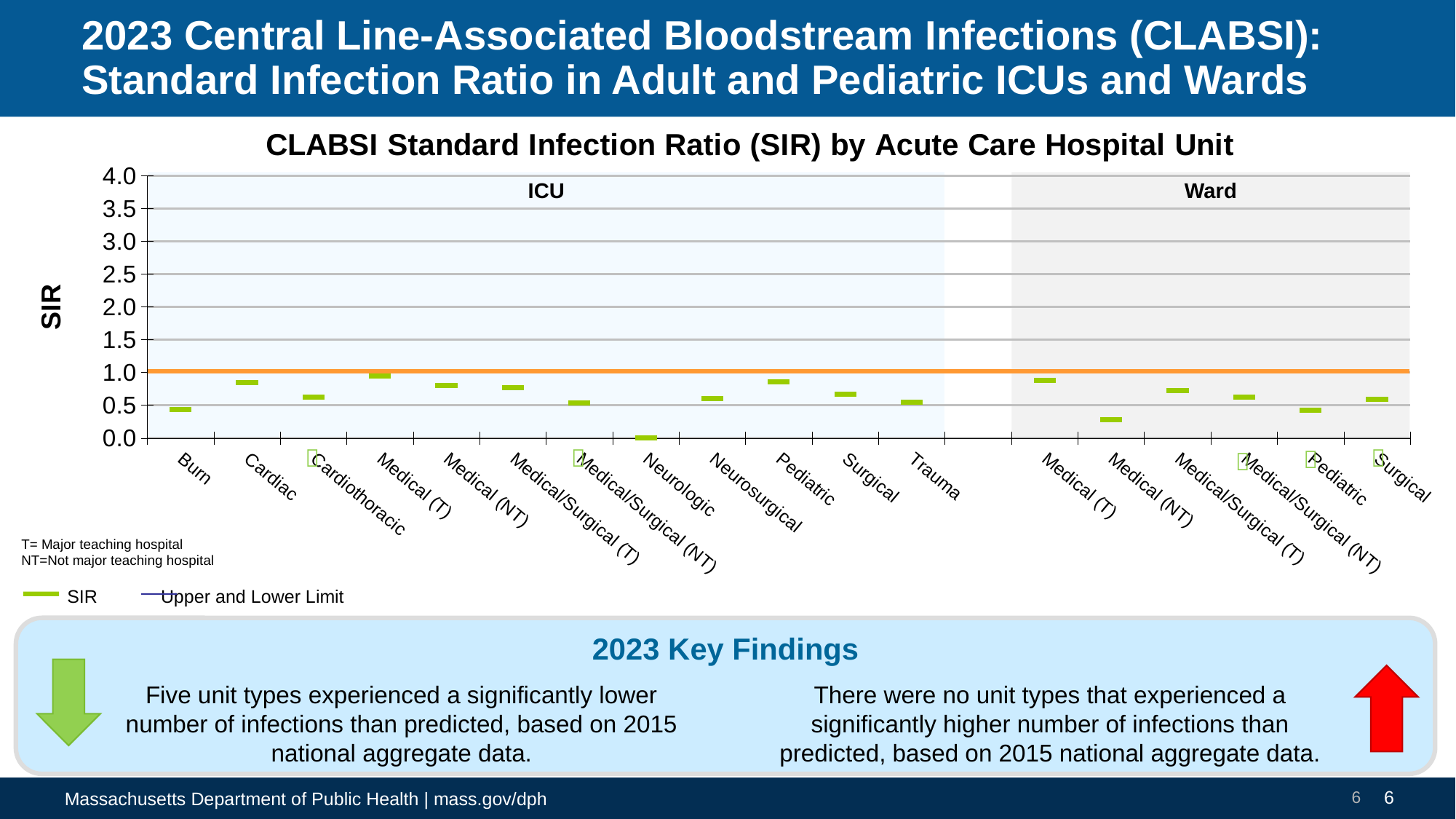
How many entries does the chart legend list? 2 Which unit has the highest SIR on the chart? Medical (T) in the ICU section How many unit types are plotted in the ICU section of the chart? 12 Is the SIR for the Cardiac ICU greater or less than 0.5? greater Which unit has the lowest SIR on the chart? Neurologic (ICU) Is the SIR for the Burn ICU greater or less than 0.5? less Which has a higher SIR, the Medical (T) Ward or the Medical (NT) Ward? Medical (T) Ward What is the label on the vertical axis of the chart? SIR Is the SIR for the Medical (NT) Ward greater or less than 0.5? less How many unit types are plotted in the Ward section of the chart? 6 Which has a higher SIR, the Cardiac ICU or the Burn ICU? Cardiac ICU